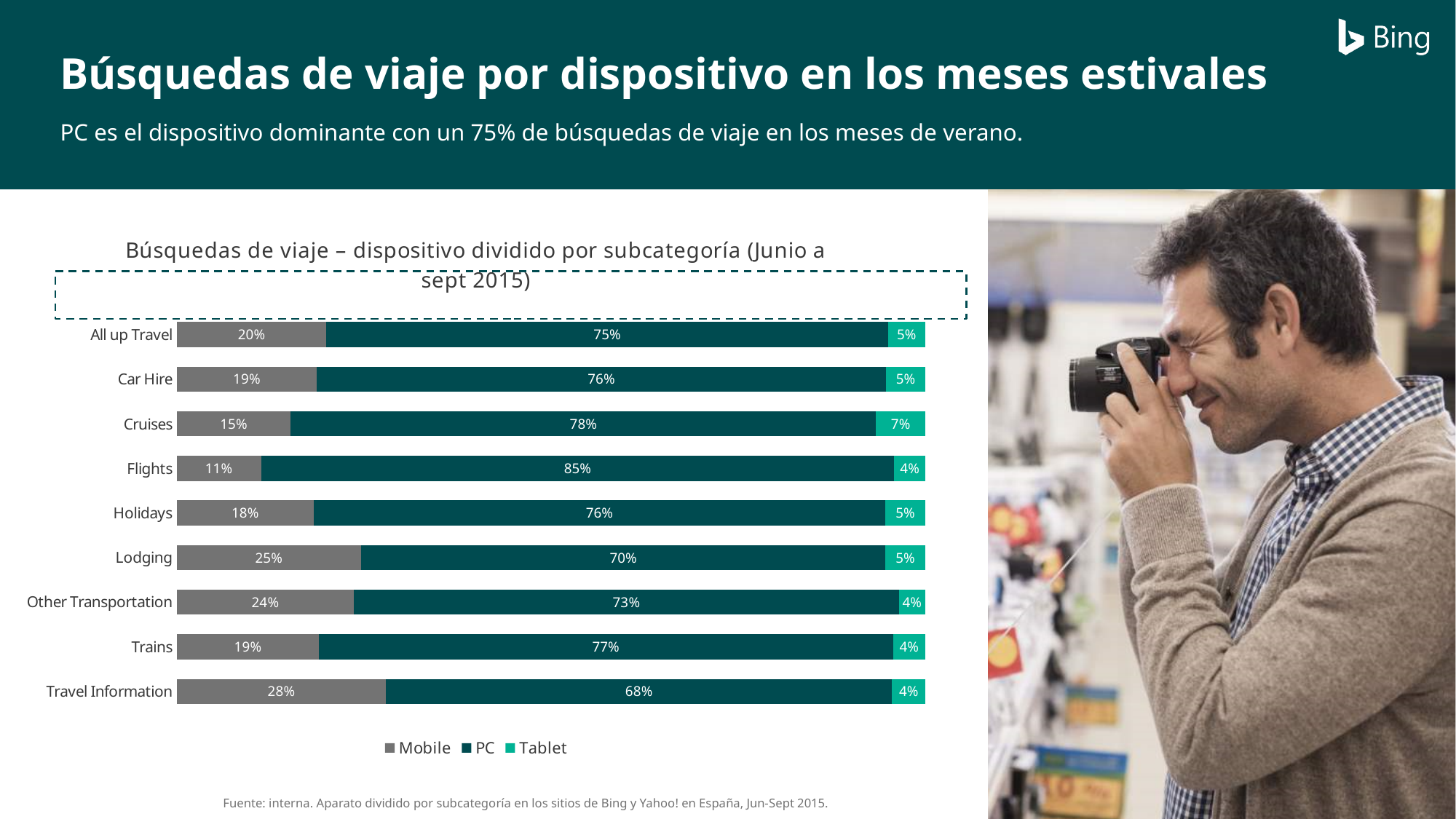
Which category has the lowest Mobile share? Flights What is the Mobile value for Travel Information? 28% Which category has the highest PC share? Flights Which series is shown in grey in the legend? Mobile What is the Tablet value for Cruises? 7% What is the PC value for Flights? 85% What kind of chart is shown on the slide? Stacked bar chart How many categories are shown in the chart? 9 What is the difference between the Mobile values for Lodging and Cruises? 10% How many series does the legend list? 3 Which is larger, the PC value for Trains or the PC value for Lodging? Trains What is the total of the stacked bar for All up Travel? 100%